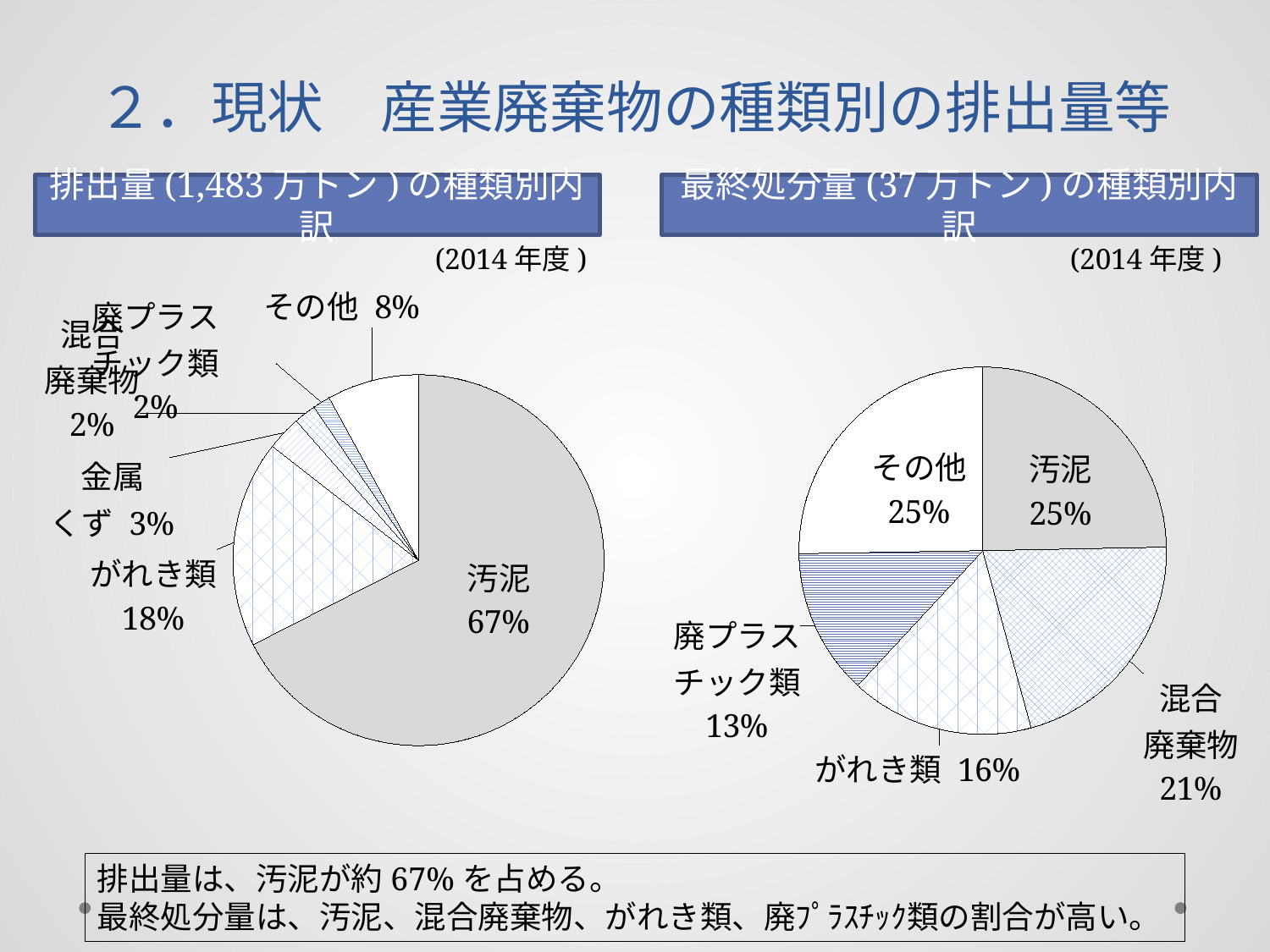
In the right chart (最終処分量の種類別内訳), what share does がれき類 account for? 16% In the left chart (排出量の種類別内訳), what share does その他 account for? 8% How many slices does the right chart (最終処分量の種類別内訳) have? 5 What kind of chart is used for the 排出量(1,483万トン)の種類別内訳 on the left? pie chart In the left chart (排出量の種類別内訳), which category has the largest share? 汚泥 In the right chart (最終処分量の種類別内訳), which is larger, the share of 混合廃棄物 or the share of がれき類? 混合廃棄物 In the left chart (排出量の種類別内訳), what is the difference between the shares of 汚泥 and がれき類? 49 percentage points In the left chart (排出量の種類別内訳), what share does がれき類 account for? 18% In the left chart (排出量の種類別内訳), what share does 汚泥 account for? 67% In the right chart (最終処分量の種類別内訳), which category has the smallest share? 廃プラスチック類 In the right chart (最終処分量の種類別内訳), what share does 廃プラスチック類 account for? 13% In the right chart (最終処分量の種類別内訳), what share does 混合廃棄物 account for? 21%